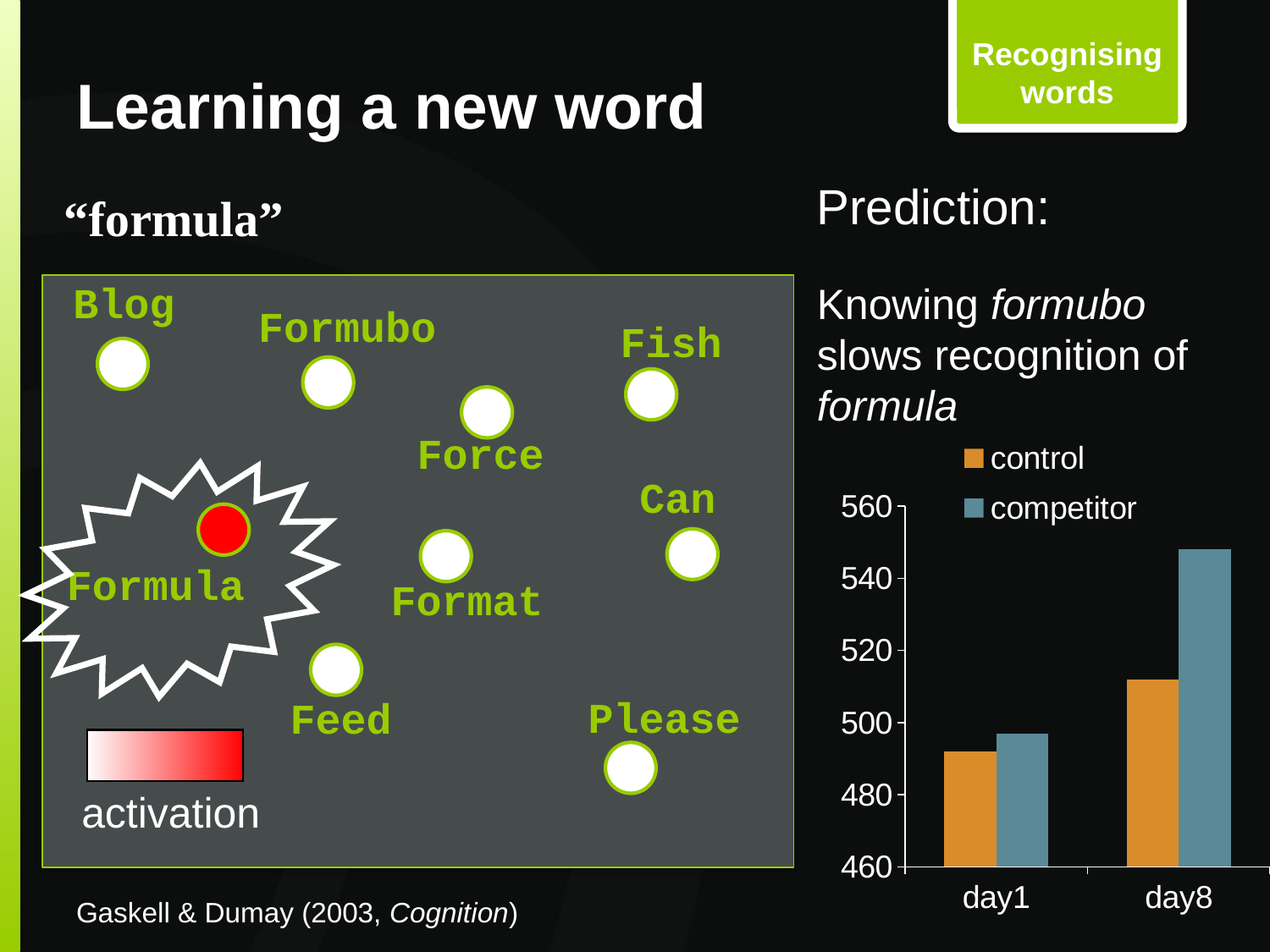
Does the competitor series rise or fall from day1 to day8? rise How many series does the legend of the bar chart list? 2 Is the value for control at day8 greater or less than 500? greater Is the value for control at day1 greater or less than 500? less Does the control series rise or fall from day1 to day8? rise How many categories are shown on the x axis of the bar chart? 2 Which category and series has the tallest bar in the chart? competitor at day8 What are the two series named in the legend of the bar chart? control and competitor Which category and series has the shortest bar in the chart? control at day1 At day8, which is larger: the control bar or the competitor bar? competitor What kind of chart is shown on the right of the slide? bar chart Is the value for competitor at day8 greater or less than 540? greater